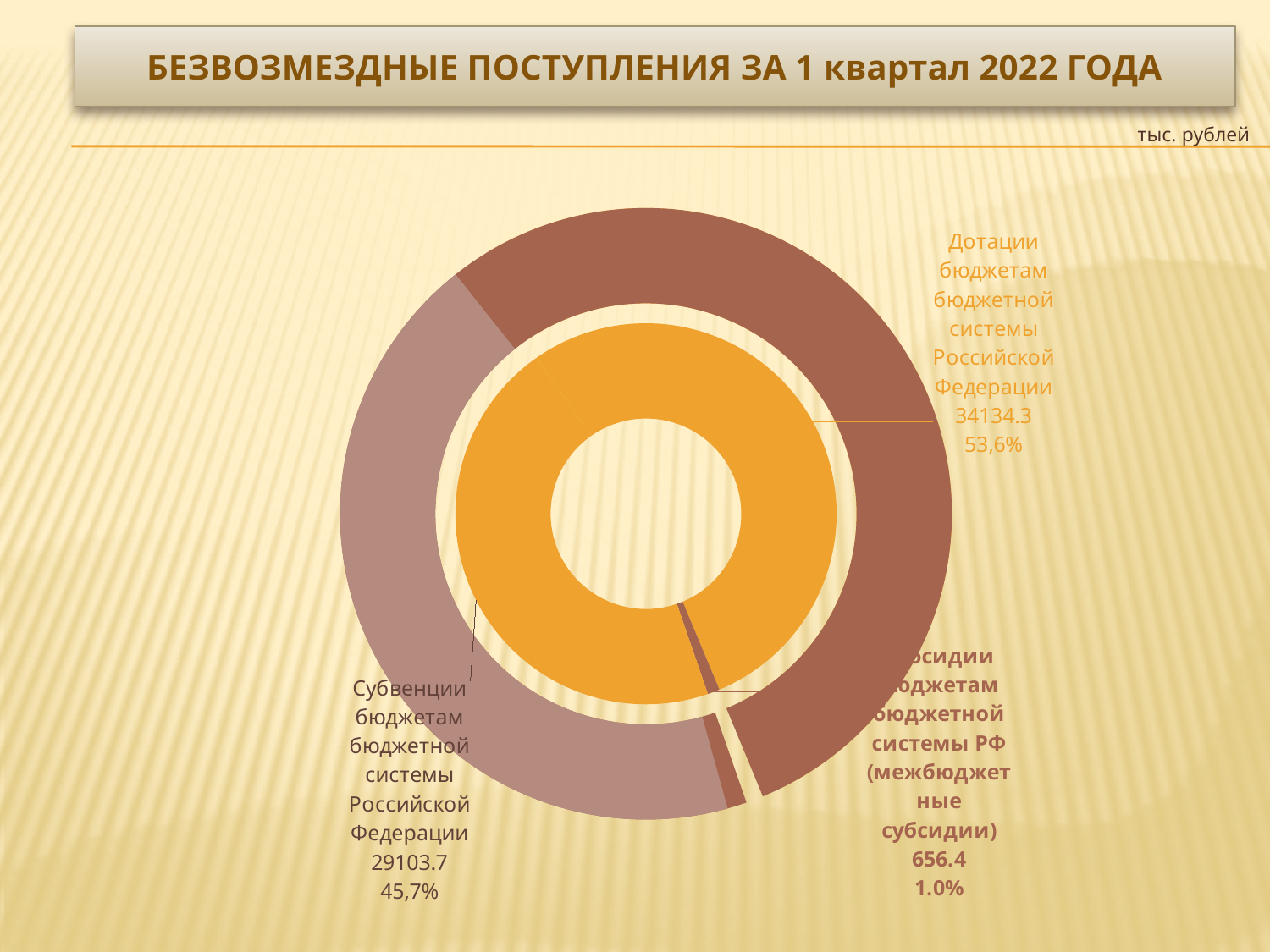
What value is shown for Субсидии бюджетам бюджетной системы РФ (межбюджетные субсидии)? 656.4 What share of the total do Субсидии бюджетам бюджетной системы РФ (межбюджетные субсидии) make up? 1.0% Which category has the smallest value? Субсидии бюджетам бюджетной системы РФ (межбюджетные субсидии) How many categories are shown in the chart? 3 What share of the total do Дотации бюджетам бюджетной системы Российской Федерации make up? 53,6% What kind of chart is shown on the slide? Doughnut chart Which category has the largest value? Дотации бюджетам бюджетной системы Российской Федерации Which is larger, the value for Субвенции or the value for Субсидии? Субвенции What is the difference between the values for Дотации and Субвенции? 5030.6 What value is shown for Дотации бюджетам бюджетной системы Российской Федерации? 34134.3 What value is shown for Субвенции бюджетам бюджетной системы Российской Федерации? 29103.7 What share of the total do Субвенции бюджетам бюджетной системы Российской Федерации make up? 45,7%